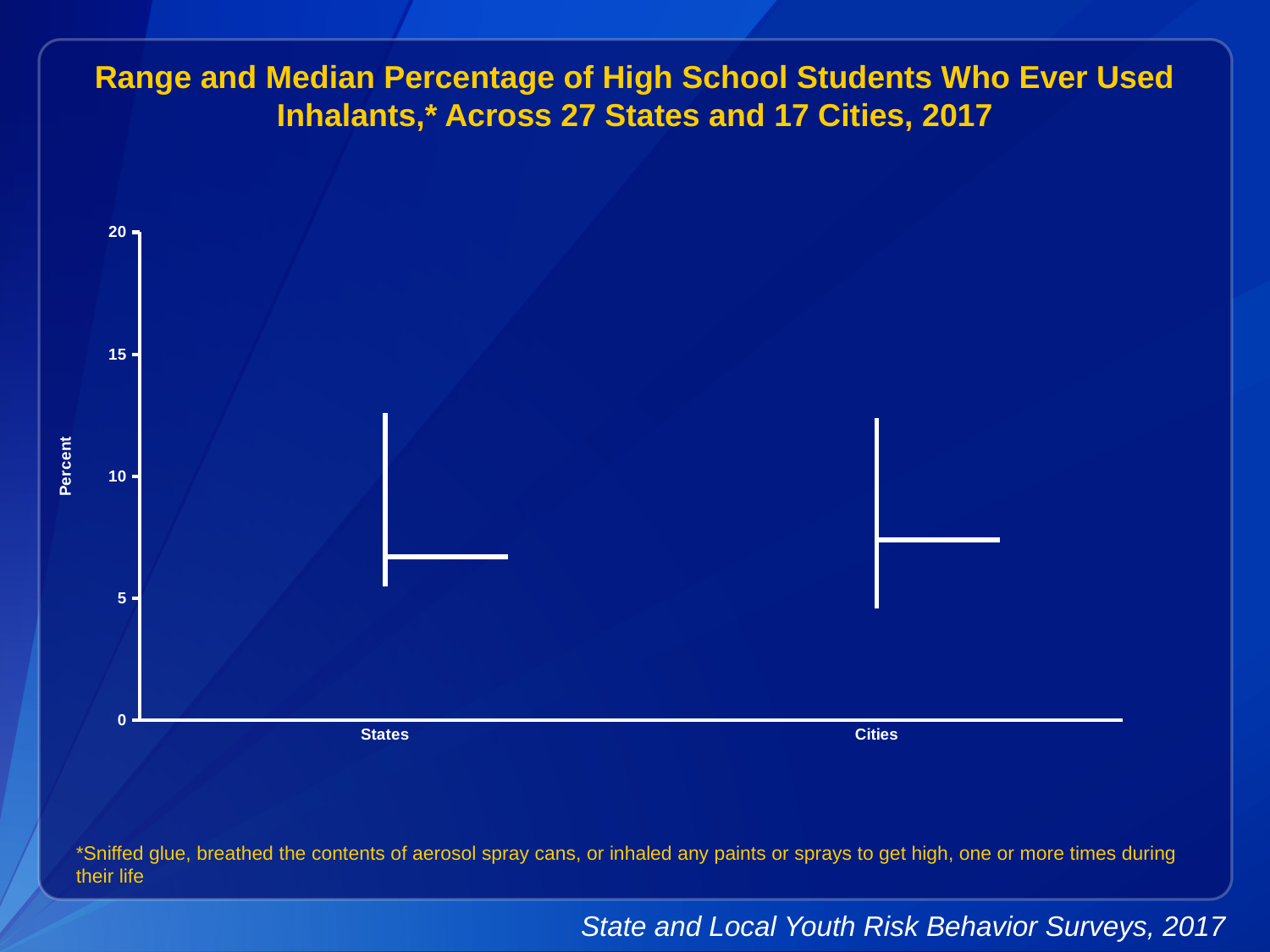
How many categories are shown on the x axis of the chart? 2 What are the two categories shown on the x axis? States and Cities Which category has the higher median value, States or Cities? Cities Is the median value for Cities greater or less than 5? greater Is the top of the range for States greater or less than 15? less Is the top of the range for States greater or less than 10? greater What is the label on the y axis of the chart? Percent What is the highest value shown on the y axis of the chart? 20